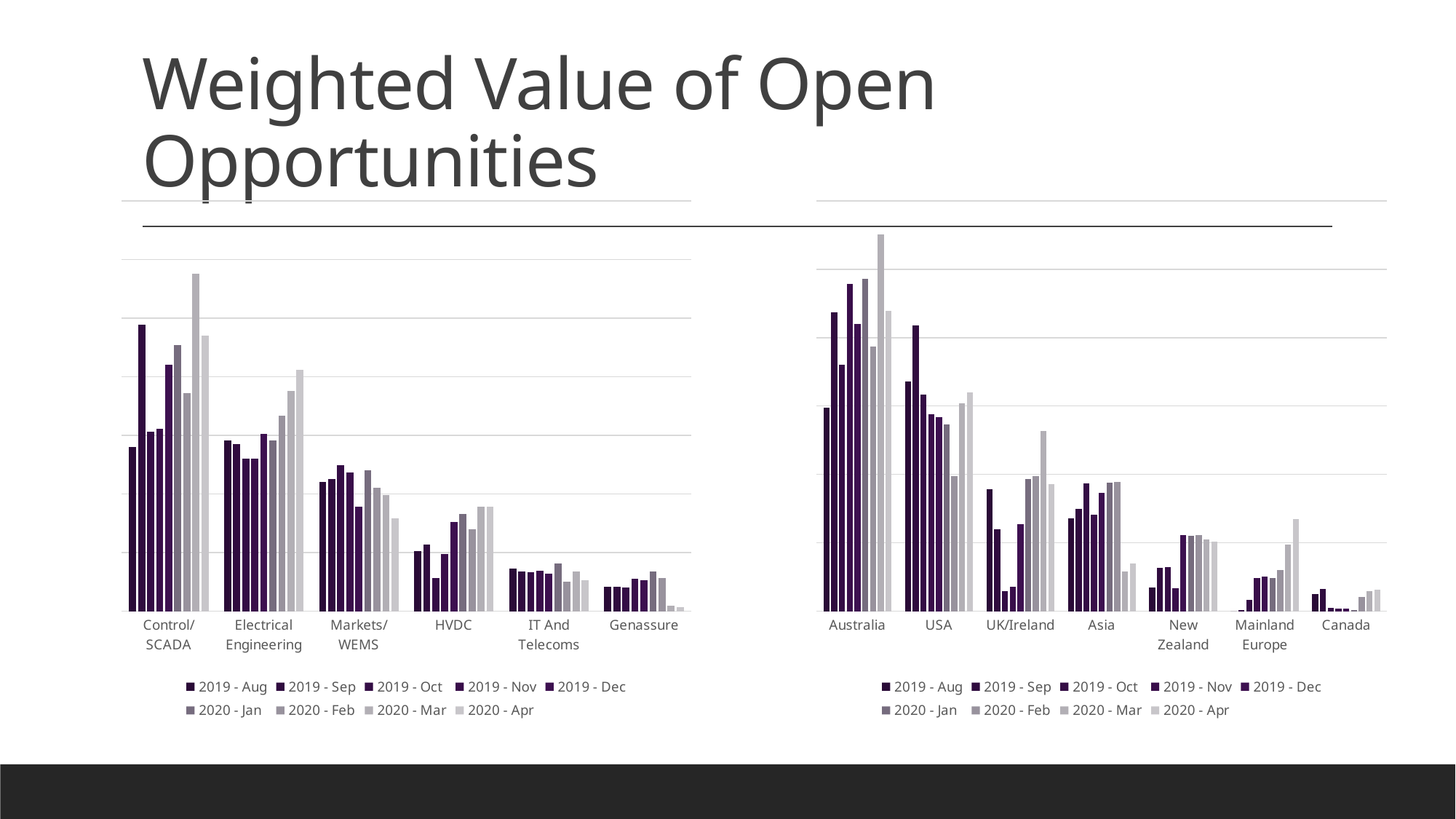
In the left chart, which is larger for 2020 - Mar: Control/SCADA or HVDC? Control/SCADA What kind of chart is the left chart on the slide? bar chart In the left chart, which category has the tallest bar overall? Control/SCADA How many categories are shown on the x axis of the right chart? 7 How many series does the legend of the right chart list? 9 In the right chart, which series has the highest value for Australia? 2020 - Mar In the right chart, which category has the lowest bars overall? Canada In the right chart, which is larger for 2019 - Aug: Australia or USA? USA What is the title of the slide? Weighted Value of Open Opportunities In the right chart, which category has the tallest bar overall? Australia In the left chart, which category has the lowest bars overall? Genassure How many categories are shown on the x axis of the left chart? 6